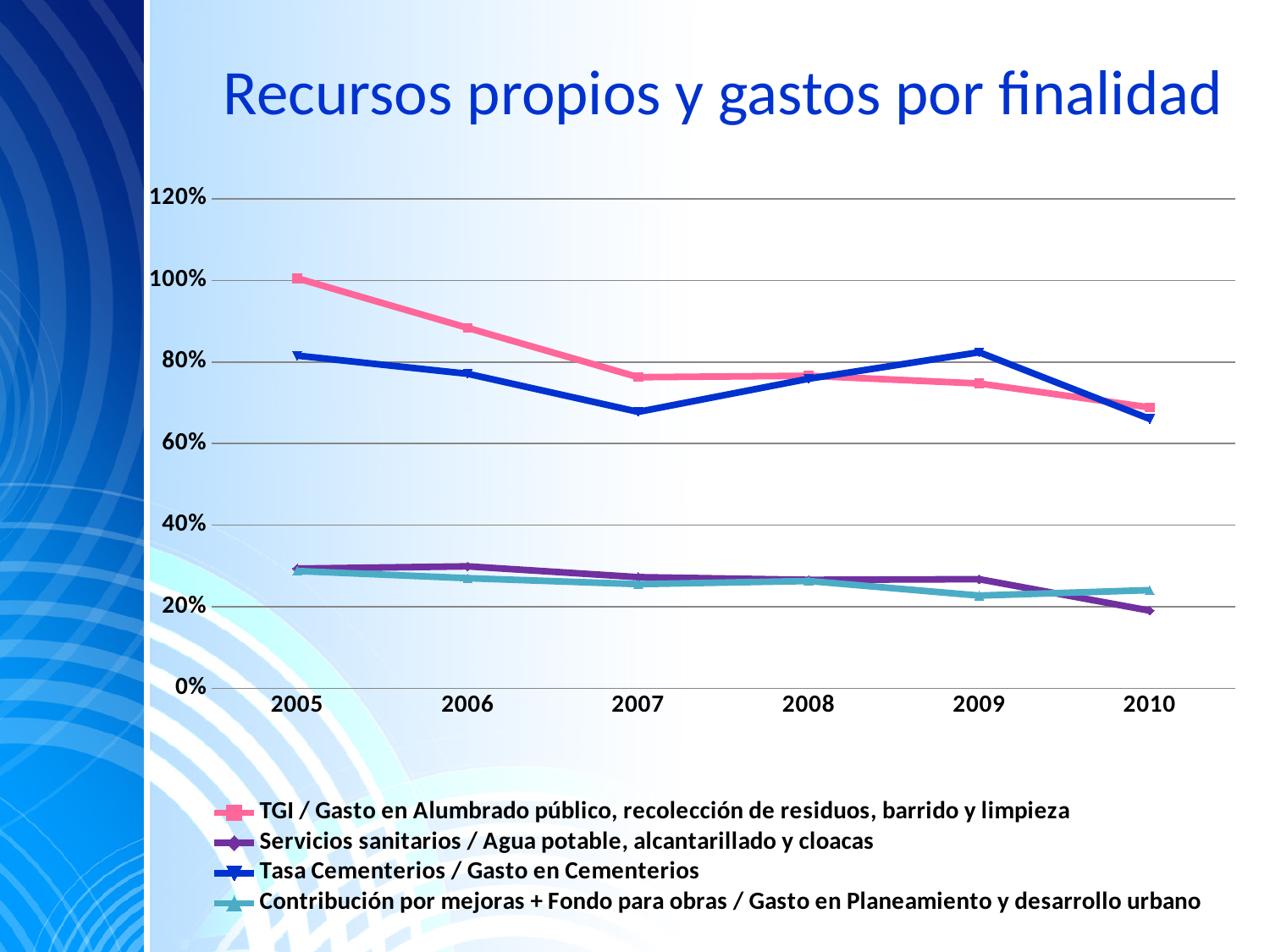
Is the value for Contribución por mejoras + Fondo para obras / Gasto en Planeamiento y desarrollo urbano in 2009 greater or less than 40%? less How many series does the legend list? 4 Does the TGI / Gasto en Alumbrado público, recolección de residuos, barrido y limpieza series rise or fall overall from 2005 to 2010? fall Which series is shown in pink in the legend? TGI / Gasto en Alumbrado público, recolección de residuos, barrido y limpieza Is the value for Tasa Cementerios / Gasto en Cementerios in 2007 greater or less than 80%? less What is the title of the chart? Recursos propios y gastos por finalidad In 2005, which is larger: TGI / Gasto en Alumbrado público, recolección de residuos, barrido y limpieza or Tasa Cementerios / Gasto en Cementerios? TGI / Gasto en Alumbrado público, recolección de residuos, barrido y limpieza Is the value for TGI / Gasto en Alumbrado público, recolección de residuos, barrido y limpieza in 2005 greater or less than 80%? greater What kind of chart is shown on the slide? line chart In 2009, which is larger: Tasa Cementerios / Gasto en Cementerios or TGI / Gasto en Alumbrado público, recolección de residuos, barrido y limpieza? Tasa Cementerios / Gasto en Cementerios How many years are shown on the x axis? 6